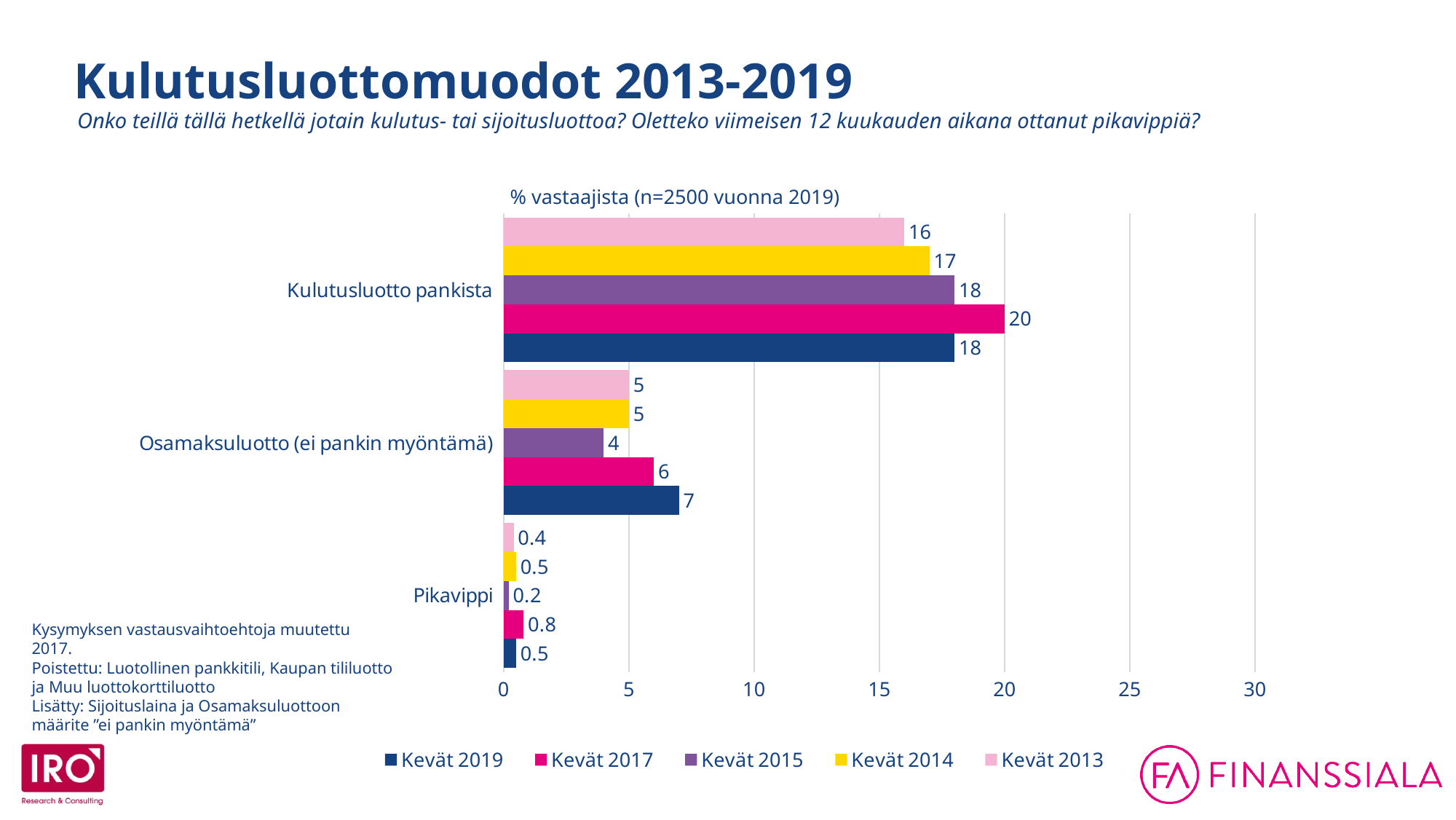
Which series has the highest value for Kulutusluotto pankista? Kevät 2017 How many categories are shown on the chart? 3 Which series has the lowest value for Pikavippi? Kevät 2015 Is the Kevät 2019 value for Kulutusluotto pankista greater or less than 15? greater What is the difference between the Kevät 2017 and Kevät 2013 values for Kulutusluotto pankista? 4 What is the title of the chart? % vastaajista (n=2500 vuonna 2019) What kind of chart is shown on the slide? bar chart Which is larger for Osamaksuluotto (ei pankin myöntämä): the Kevät 2019 value or the Kevät 2015 value? Kevät 2019 What is the value for Osamaksuluotto (ei pankin myöntämä) in the Kevät 2019 series? 7 What is the value for Kulutusluotto pankista in the Kevät 2017 series? 20 How many series does the legend list? 5 What is the value for Pikavippi in the Kevät 2015 series? 0.2